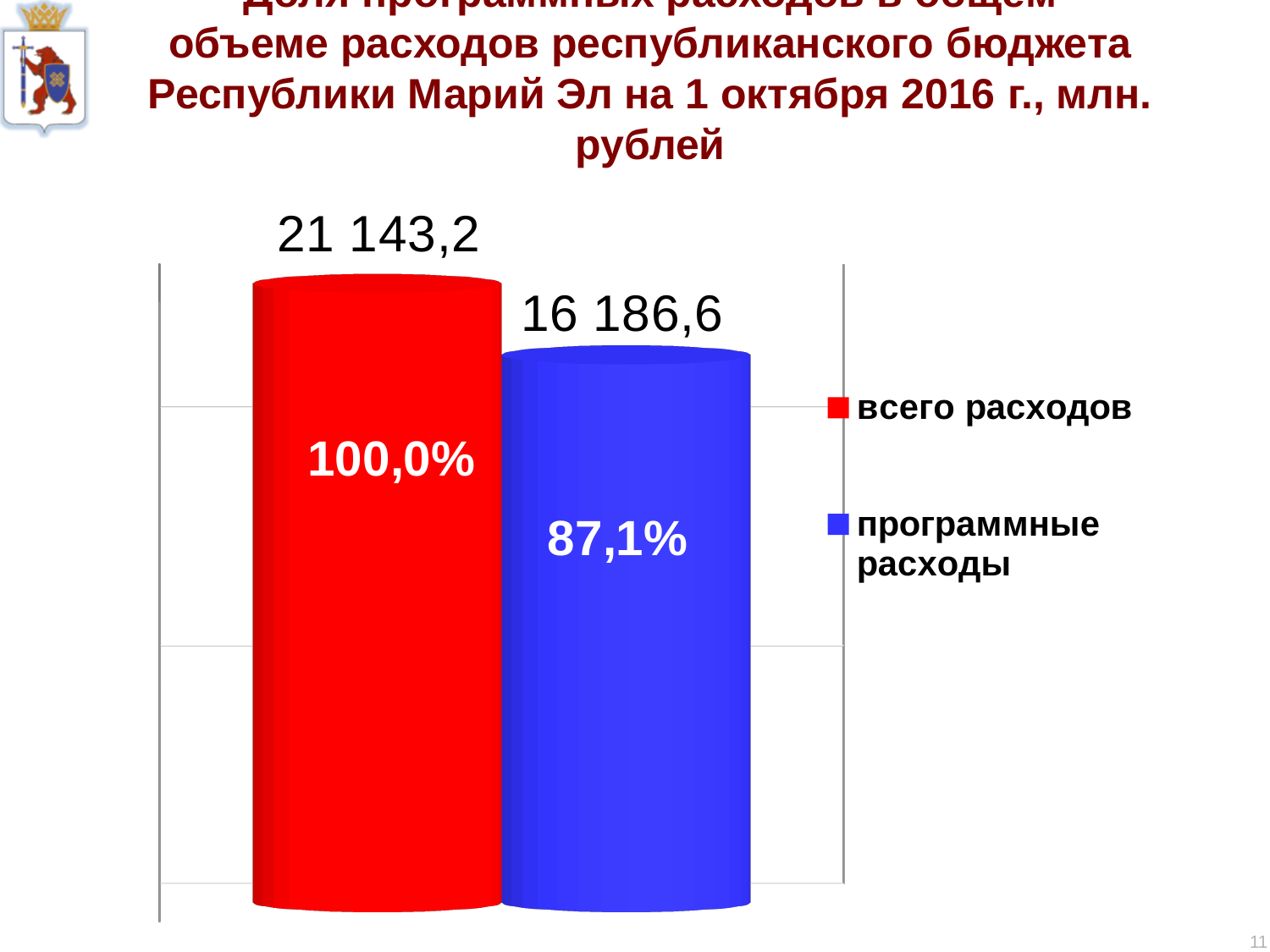
What percentage is shown on the «программные расходы» bar? 87,1% What percentage is shown on the «всего расходов» bar? 100,0% What kind of chart is shown on the slide? Bar chart How many bars are plotted on the chart? 2 What is the value for «программные расходы»? 16 186,6 What colour is the «программные расходы» bar? Blue What is the difference between «всего расходов» and «программные расходы»? 4 956,6 Which is larger: «всего расходов» or «программные расходы»? всего расходов How many series does the legend list? 2 What is the value for «всего расходов»? 21 143,2 Which series has the highest value? всего расходов Which series has the lowest value? программные расходы